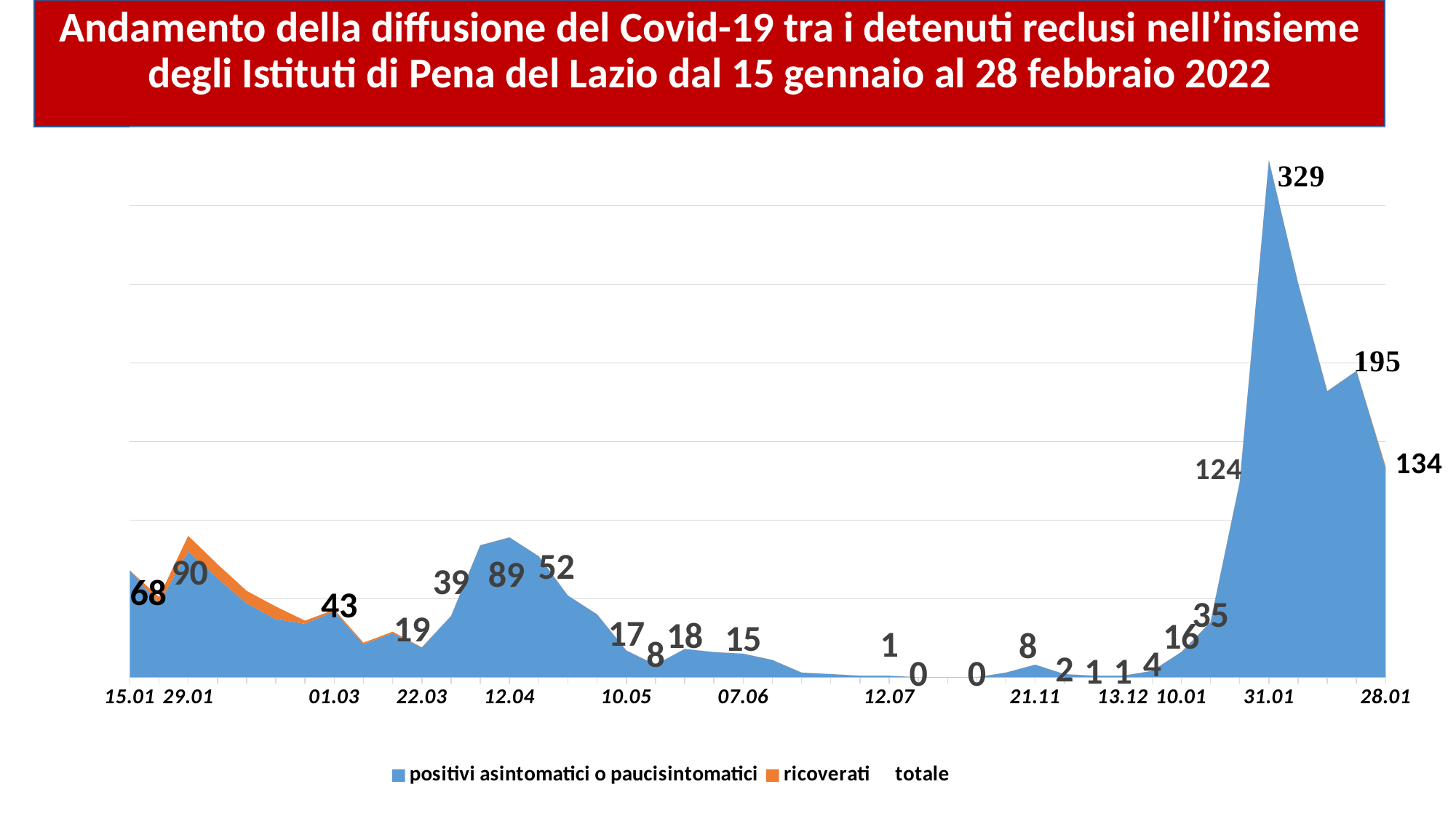
What is the total value shown for 15.01? 68 What is the total value shown for 31.01? 329 What is the total value shown for 12.04? 89 What is the total value shown for 29.01? 90 What is the difference between the peak value 329 and the following labelled value 195? 134 How many series does the legend list? 3 What is the total value shown for 12.07? 1 What kind of chart is shown on the slide? Area chart What is the total value shown for 28.01 at the right end of the chart? 134 Which is larger, the value for 29.01 or the value for 15.01? 29.01 On which date does the chart reach its highest value? 31.01 Do the values rise or fall between 10.01 and 31.01? Rise